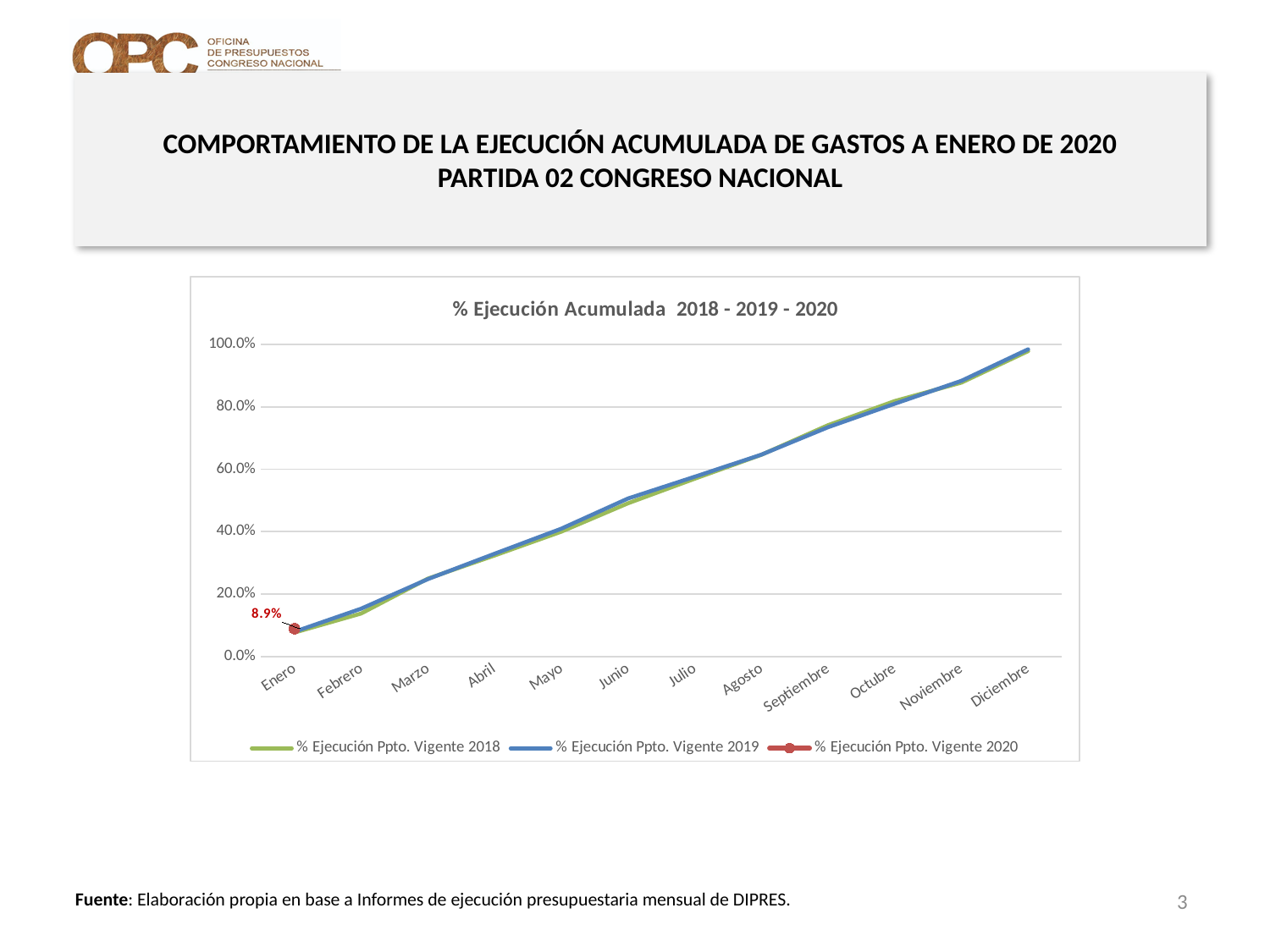
What is the title of the chart? % Ejecución Acumulada 2018 - 2019 - 2020 Is the value for % Ejecución Ppto. Vigente 2019 in Diciembre greater or less than 80.0%? greater How many series does the chart legend list? 3 What is the value for % Ejecución Ppto. Vigente 2020 in Enero? 8.9% Is the value for % Ejecución Ppto. Vigente 2018 in Marzo greater or less than 40.0%? less Which month has the highest value for % Ejecución Ppto. Vigente 2018? Diciembre What kind of chart is shown on the slide? line chart Is the value for % Ejecución Ppto. Vigente 2019 in Septiembre greater or less than 60.0%? greater How many months are shown along the x axis of the chart? 12 Do the values for % Ejecución Ppto. Vigente 2019 rise or fall from Enero to Diciembre? rise Which month has the lowest value for % Ejecución Ppto. Vigente 2019? Enero